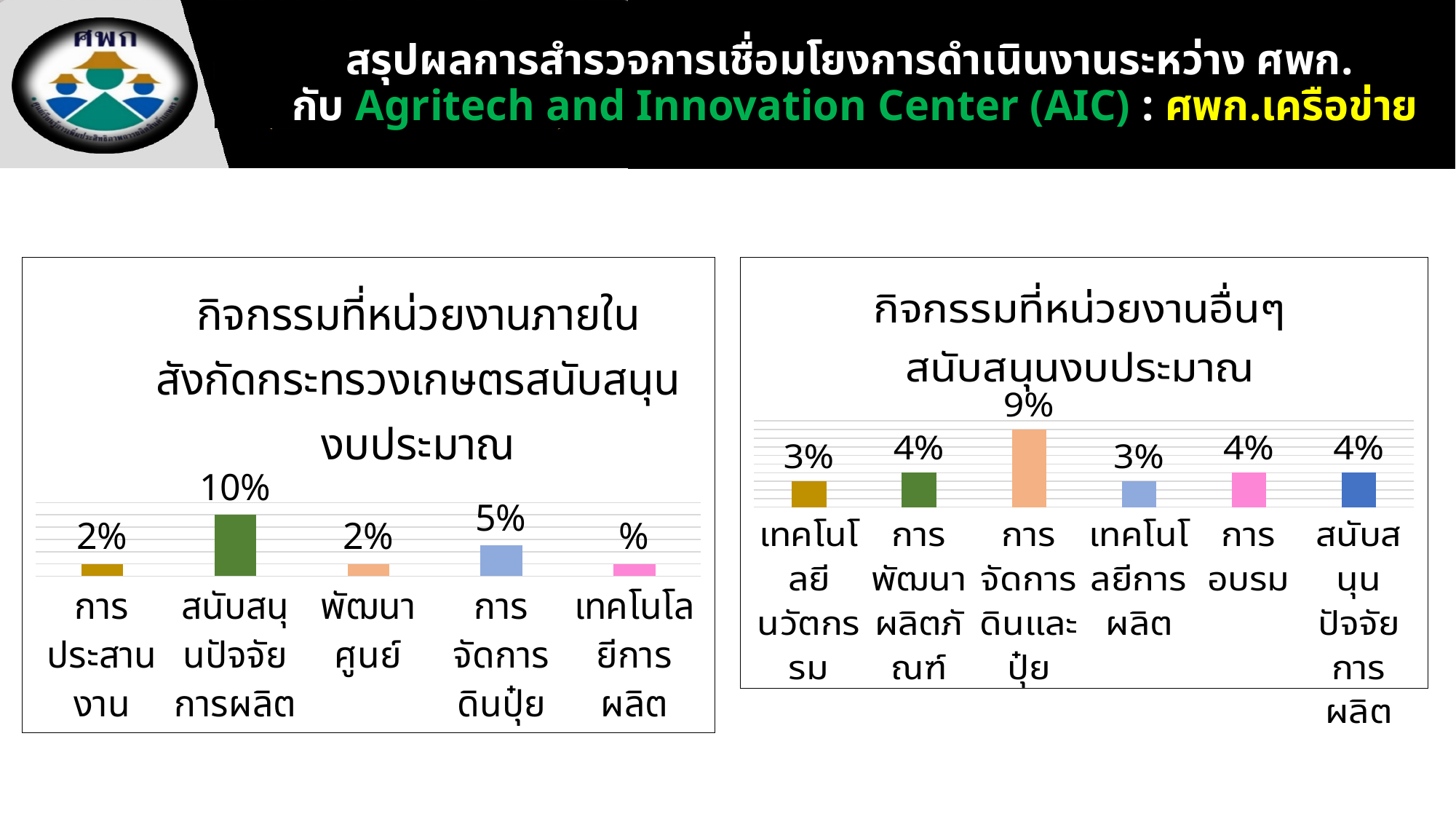
In the right chart (กิจกรรมที่หน่วยงานอื่นๆ สนับสนุนงบประมาณ), what is the difference between การจัดการดินและปุ๋ย and การพัฒนาผลิตภัณฑ์? 5% In the right chart (กิจกรรมที่หน่วยงานอื่นๆ สนับสนุนงบประมาณ), what is the value for เทคโนโลยีนวัตกรรม? 3% In the right chart (กิจกรรมที่หน่วยงานอื่นๆ สนับสนุนงบประมาณ), which category has the highest value? การจัดการดินและปุ๋ย In the left chart (กิจกรรมที่หน่วยงานภายในสังกัดกระทรวงเกษตรสนับสนุนงบประมาณ), which category has the highest value? สนับสนุนปัจจัยการผลิต In the left chart (กิจกรรมที่หน่วยงานภายในสังกัดกระทรวงเกษตรสนับสนุนงบประมาณ), how many categories are shown? 5 In the left chart (กิจกรรมที่หน่วยงานภายในสังกัดกระทรวงเกษตรสนับสนุนงบประมาณ), what is the difference between สนับสนุนปัจจัยการผลิต and การจัดการดินปุ๋ย? 5% In the right chart (กิจกรรมที่หน่วยงานอื่นๆ สนับสนุนงบประมาณ), how many categories are shown? 6 What type of chart is the right chart (กิจกรรมที่หน่วยงานอื่นๆ สนับสนุนงบประมาณ)? Bar chart In the right chart (กิจกรรมที่หน่วยงานอื่นๆ สนับสนุนงบประมาณ), what is the value for การจัดการดินและปุ๋ย? 9% In the left chart (กิจกรรมที่หน่วยงานภายในสังกัดกระทรวงเกษตรสนับสนุนงบประมาณ), what is the value for การจัดการดินปุ๋ย? 5% In the right chart (กิจกรรมที่หน่วยงานอื่นๆ สนับสนุนงบประมาณ), which is larger: การอบรม or เทคโนโลยีการผลิต? การอบรม In the left chart (กิจกรรมที่หน่วยงานภายในสังกัดกระทรวงเกษตรสนับสนุนงบประมาณ), what is the value for สนับสนุนปัจจัยการผลิต? 10%